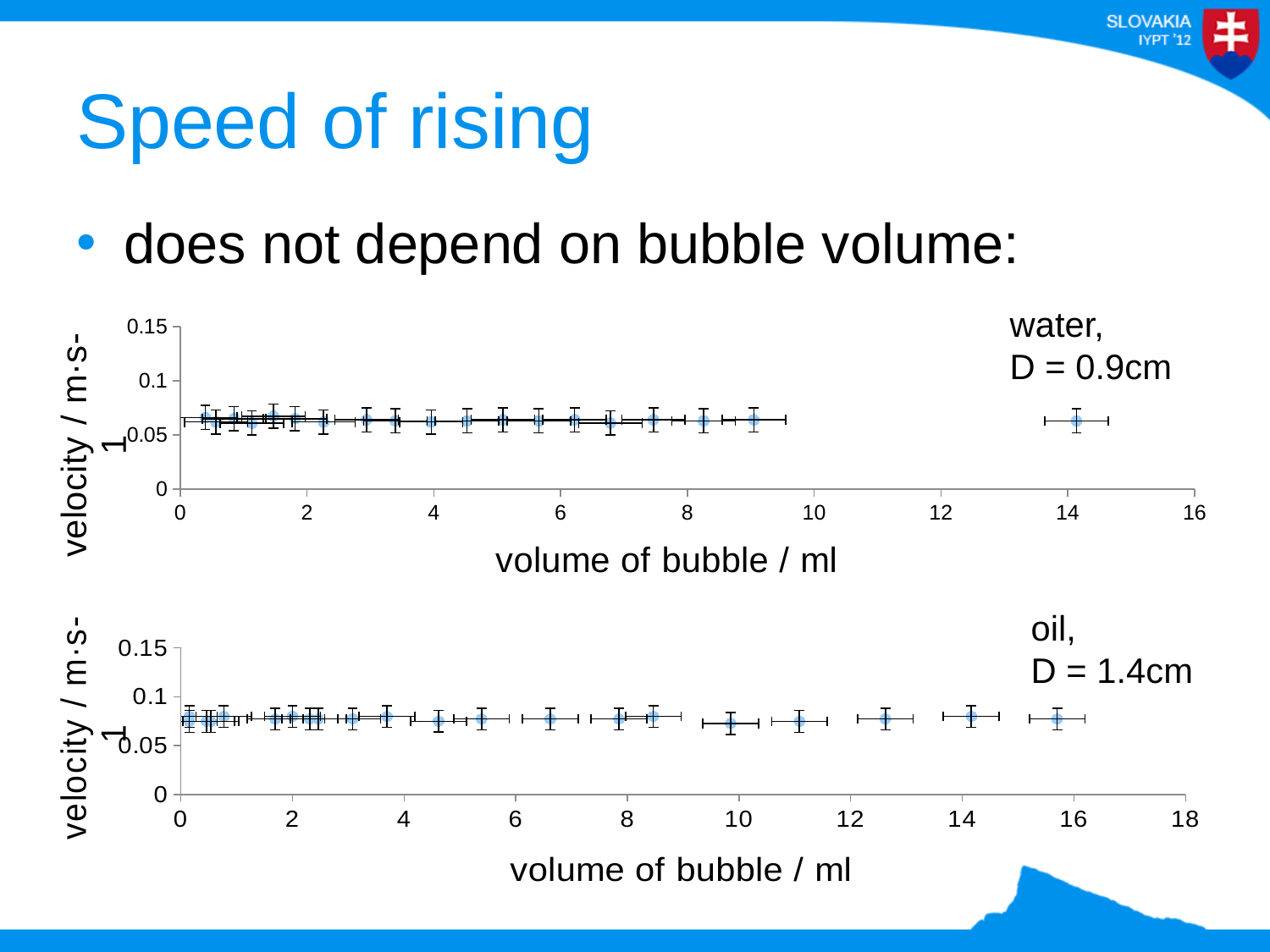
In the bottom chart (oil, D = 1.4cm), is the velocity for the bubble at about 16 ml greater or less than 0.05? greater In the top chart (water, D = 0.9cm), is the velocity for the bubble at about 14 ml greater or less than 0.05? greater What kind of chart is the bottom chart (oil, D = 1.4cm)? scatter chart In the bottom chart (oil, D = 1.4cm), do the velocity values rise, fall, or stay roughly constant as bubble volume increases? stay roughly constant What is the label of the x axis on the top chart (water, D = 0.9cm)? volume of bubble / ml In the top chart (water, D = 0.9cm), is the velocity for the bubble at about 14 ml greater or less than 0.1? less In the top chart (water, D = 0.9cm), do the velocity values rise, fall, or stay roughly constant as bubble volume increases? stay roughly constant What is the highest value shown on the x axis of the bottom chart (oil, D = 1.4cm)? 18 What kind of chart is the top chart (water, D = 0.9cm)? scatter chart